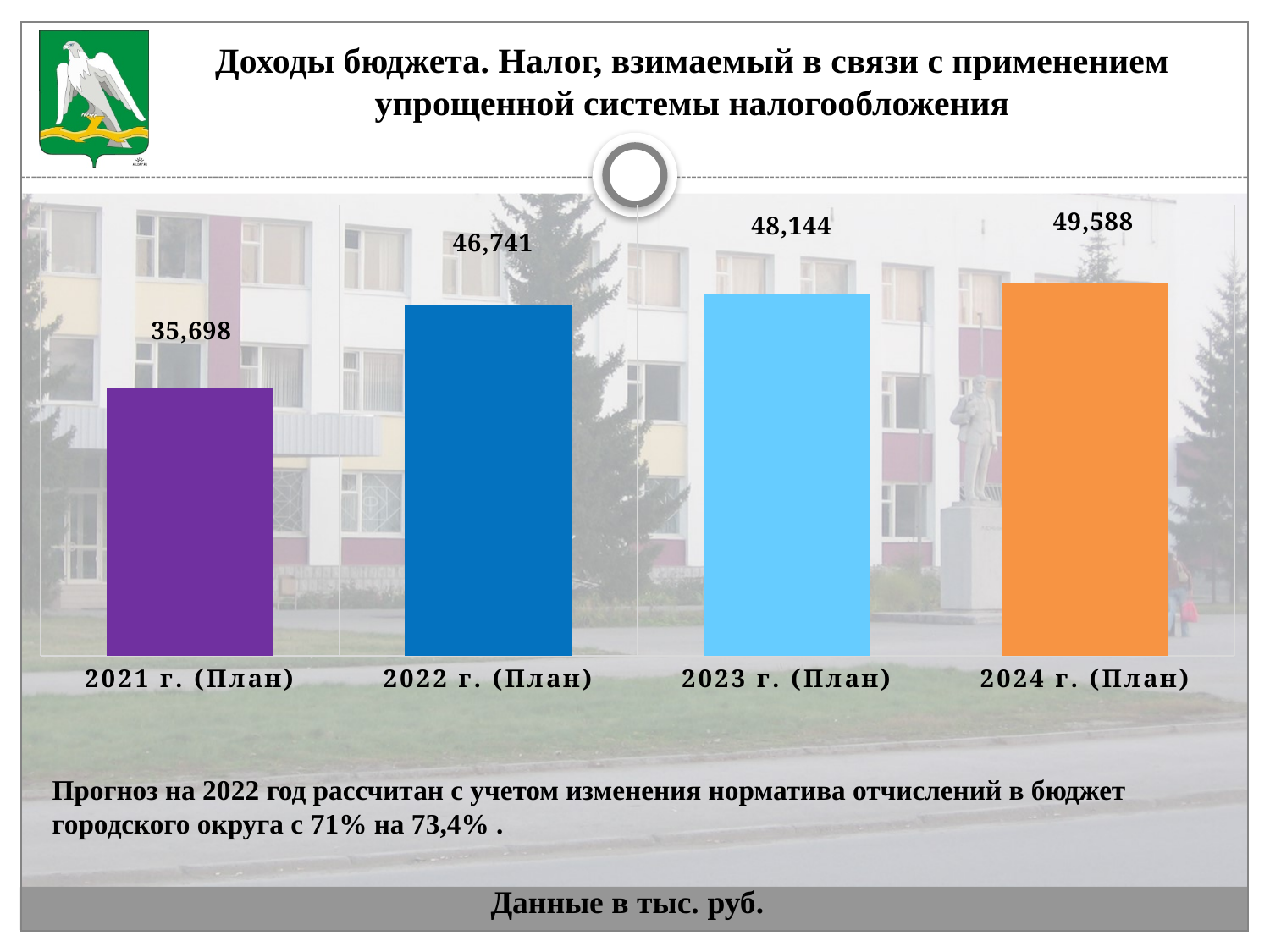
Which year has the highest value? 2024 г. (План) What is the value for 2024 г. (План)? 49,588 What is the value for 2023 г. (План)? 48,144 What is the difference between the values for 2022 г. (План) and 2021 г. (План)? 11,043 Which year has the lowest value? 2021 г. (План) What is the difference between the values for 2024 г. (План) and 2023 г. (План)? 1,444 What kind of chart is shown on the slide? Bar chart How many bars are shown in the chart? 4 Which is larger, the value for 2022 г. (План) or 2021 г. (План)? 2022 г. (План) What is the value for 2022 г. (План)? 46,741 What is the value for 2021 г. (План)? 35,698 Do the values rise or fall from 2021 to 2024? Rise